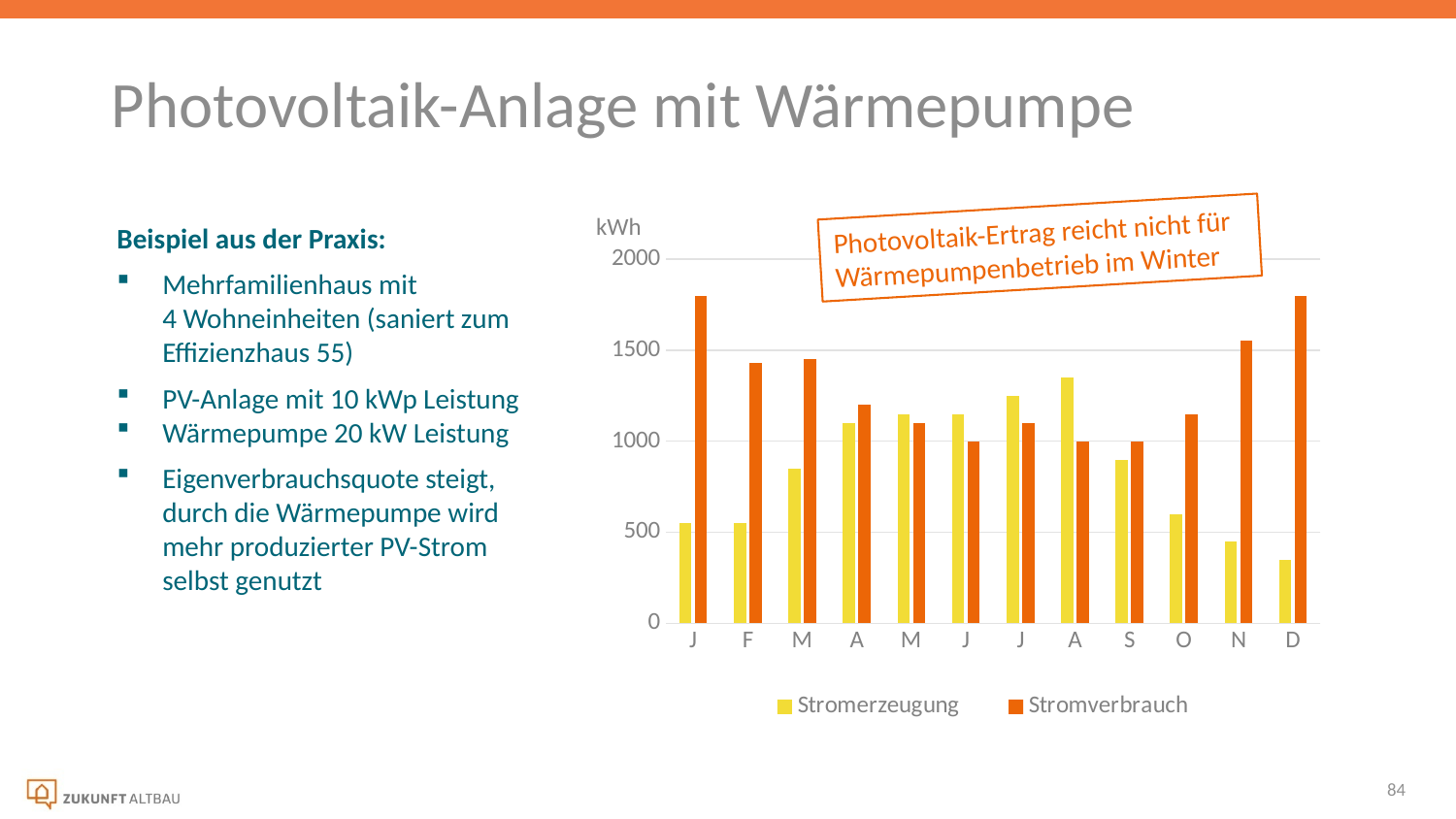
In which month is Stromerzeugung lowest? D In month D, which is larger: Stromerzeugung or Stromverbrauch? Stromverbrauch How many series does the chart legend list? 2 What unit is given on the y axis of the chart? kWh In which month is Stromerzeugung highest? A (August, the eighth month) Does Stromerzeugung rise or fall from S to D? fall Is the Stromerzeugung value for D greater or less than 500? less What kind of chart is shown on the slide? bar chart Is the Stromverbrauch value for the first month (J) greater or less than 1500? greater How many categories (months) are shown on the x axis of the chart? 12 Which series is shown in yellow in the chart? Stromerzeugung Is the Stromverbrauch value for N greater or less than 1500? greater